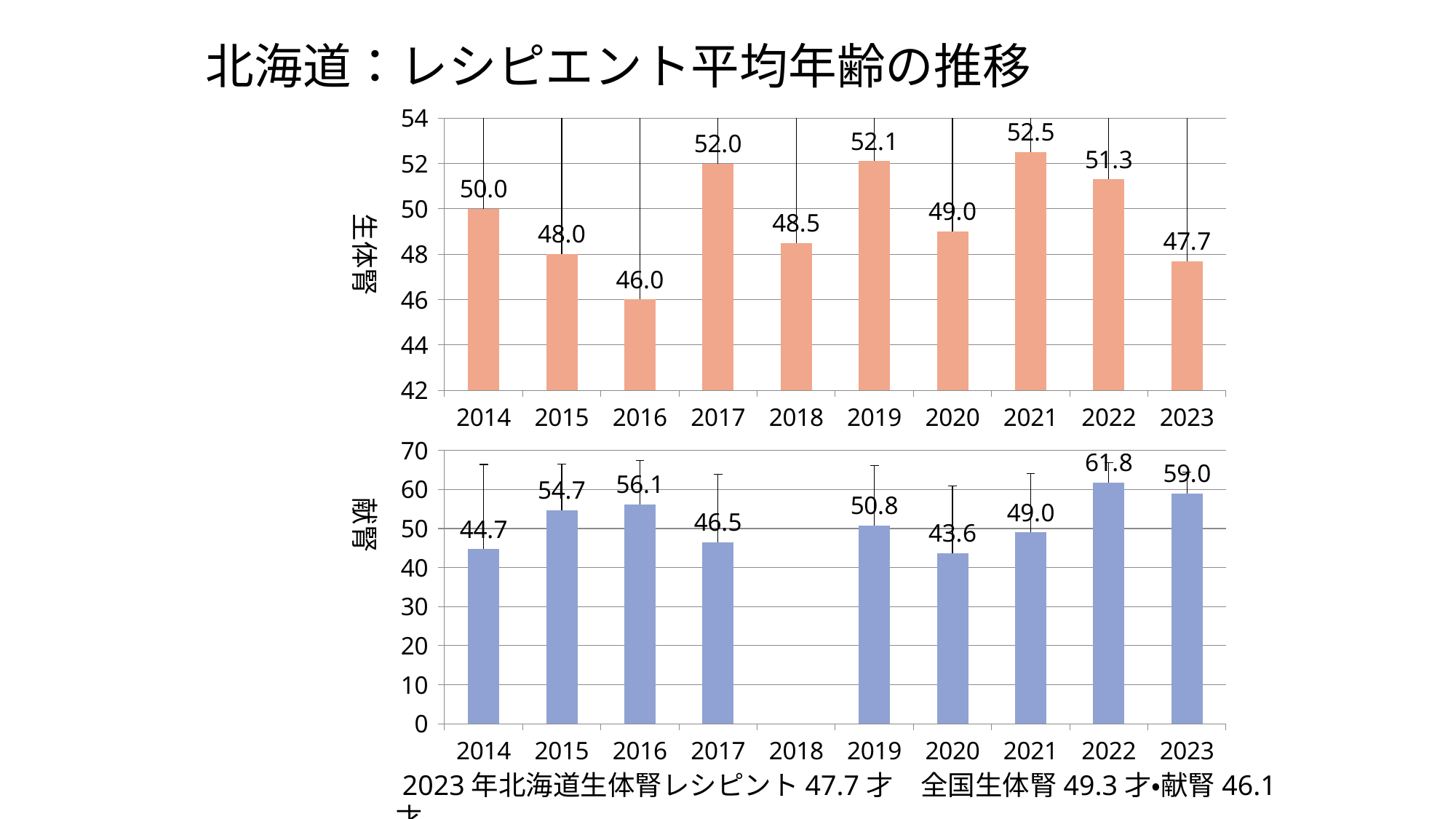
In the bottom chart (献腎), which year has the highest value? 2022 In the bottom chart (献腎), do the values rise or fall from 2020 to 2022? rise In the top chart (生体腎), which is larger, the value for 2017 or the value for 2018? 2017 How many bars are plotted in the bottom chart (献腎)? 9 In the top chart (生体腎), what is the difference between the 2021 value and the 2023 value? 4.8 In the top chart (生体腎), which year has the lowest value? 2016 In the bottom chart (献腎), is the value for 2016 greater or less than 50? greater What type of chart is the top chart (生体腎)? bar chart In the bottom chart (献腎), what is the value for 2022? 61.8 In the bottom chart (献腎), what is the difference between the 2022 value and the 2014 value? 17.1 In the bottom chart (献腎), which year has the lowest value? 2020 In the top chart (生体腎), what is the value for 2021? 52.5